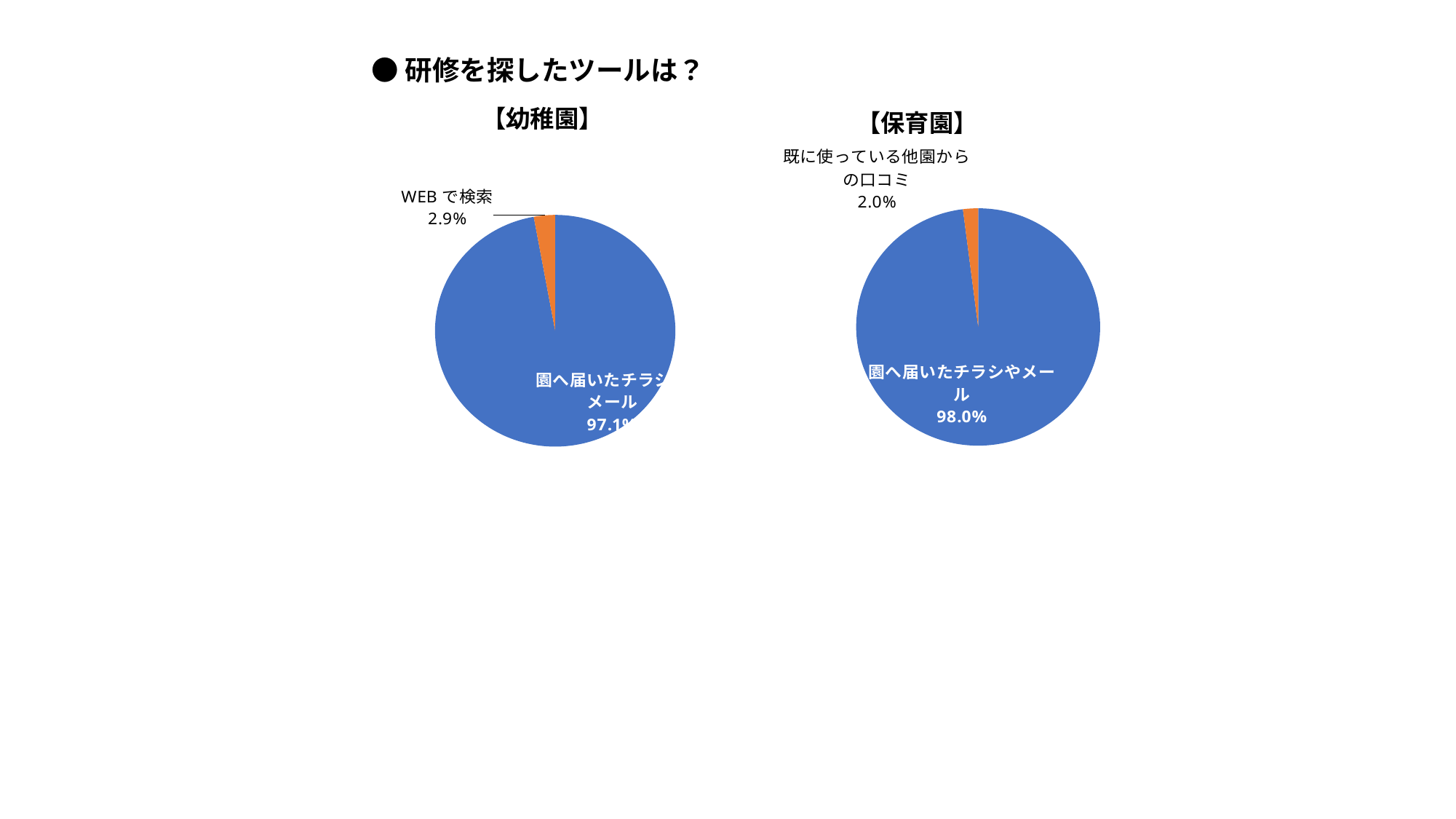
In the 【保育園】 chart, what share is labelled for 既に使っている他園からの口コミ? 2.0% Which is larger: the WEBで検索 share in the 【幼稚園】 chart or the 既に使っている他園からの口コミ share in the 【保育園】 chart? WEBで検索 in the 【幼稚園】 chart In the 【幼稚園】 chart, what share is labelled for 園へ届いたチラシやメール? 97.1% In the 【幼稚園】 chart, what share is labelled for WEBで検索? 2.9% How many slices does the 【保育園】 pie chart have? 2 What is the difference between the 園へ届いたチラシやメール share in the 【保育園】 chart and the 園へ届いたチラシやメール share in the 【幼稚園】 chart? 0.9% What colour is the 園へ届いたチラシやメール slice in the 【保育園】 chart? Blue In the 【幼稚園】 chart, which category has the largest slice? 園へ届いたチラシやメール In the 【保育園】 chart, what share is labelled for 園へ届いたチラシやメール? 98.0% How many slices does the 【幼稚園】 pie chart have? 2 What kind of chart is the 【幼稚園】 chart? Pie chart In the 【保育園】 chart, which category has the smallest slice? 既に使っている他園からの口コミ